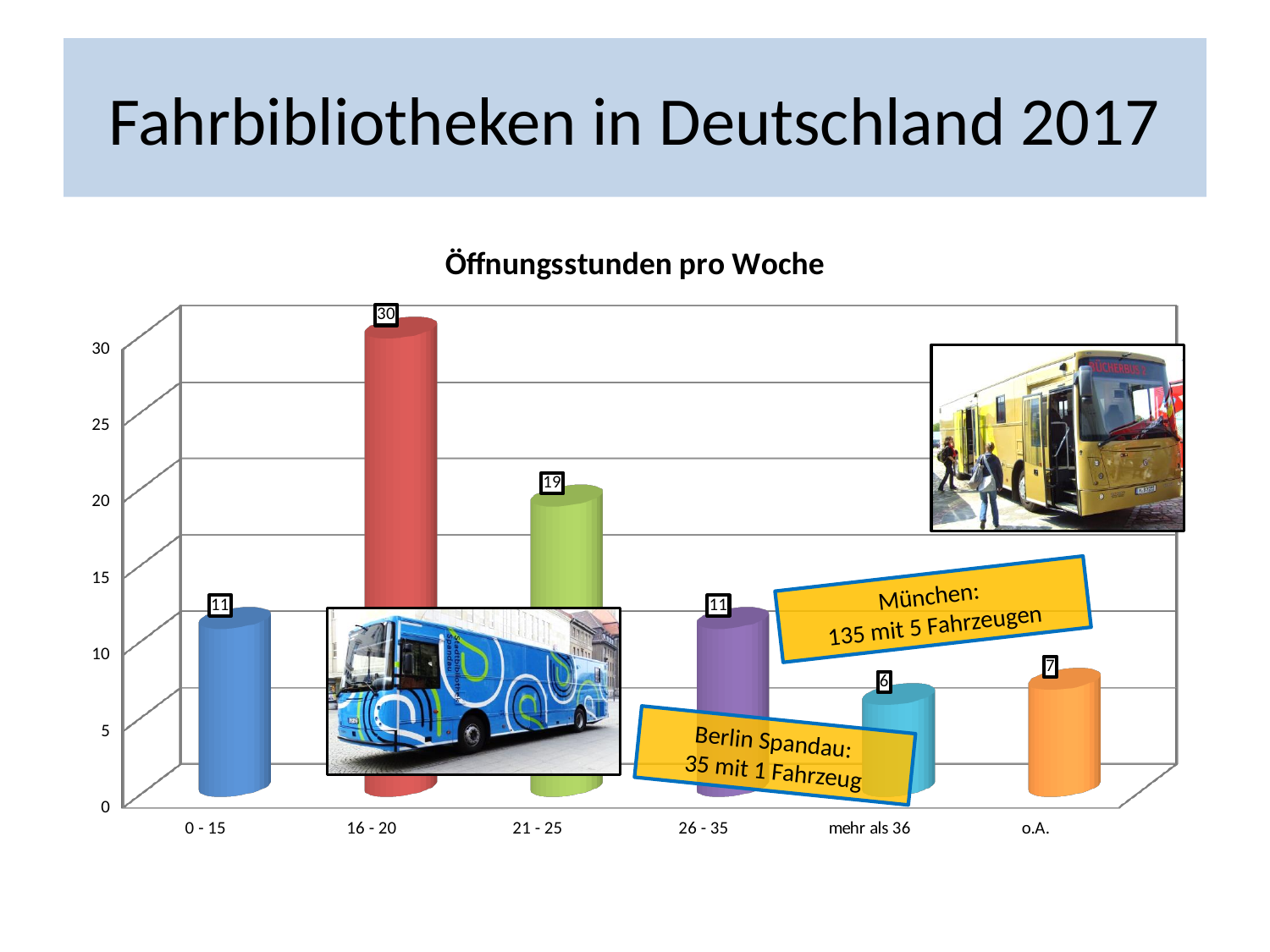
What is the value for the 'mehr als 36' category? 6 What is the value for the '16 - 20' category in the 'Öffnungsstunden pro Woche' chart? 30 What is the title of the chart? Öffnungsstunden pro Woche Is the value for '21 - 25' greater or less than 15? greater How many categories are shown on the x axis? 6 Which category has the highest value? 16 - 20 What is the difference between the values for '16 - 20' and '21 - 25'? 11 What is the value for the '21 - 25' category? 19 Which is larger, the value for '0 - 15' or the value for 'o.A.'? 0 - 15 What is the value for the 'o.A.' category? 7 Which category has the lowest value? mehr als 36 What kind of chart is shown on the slide? bar chart